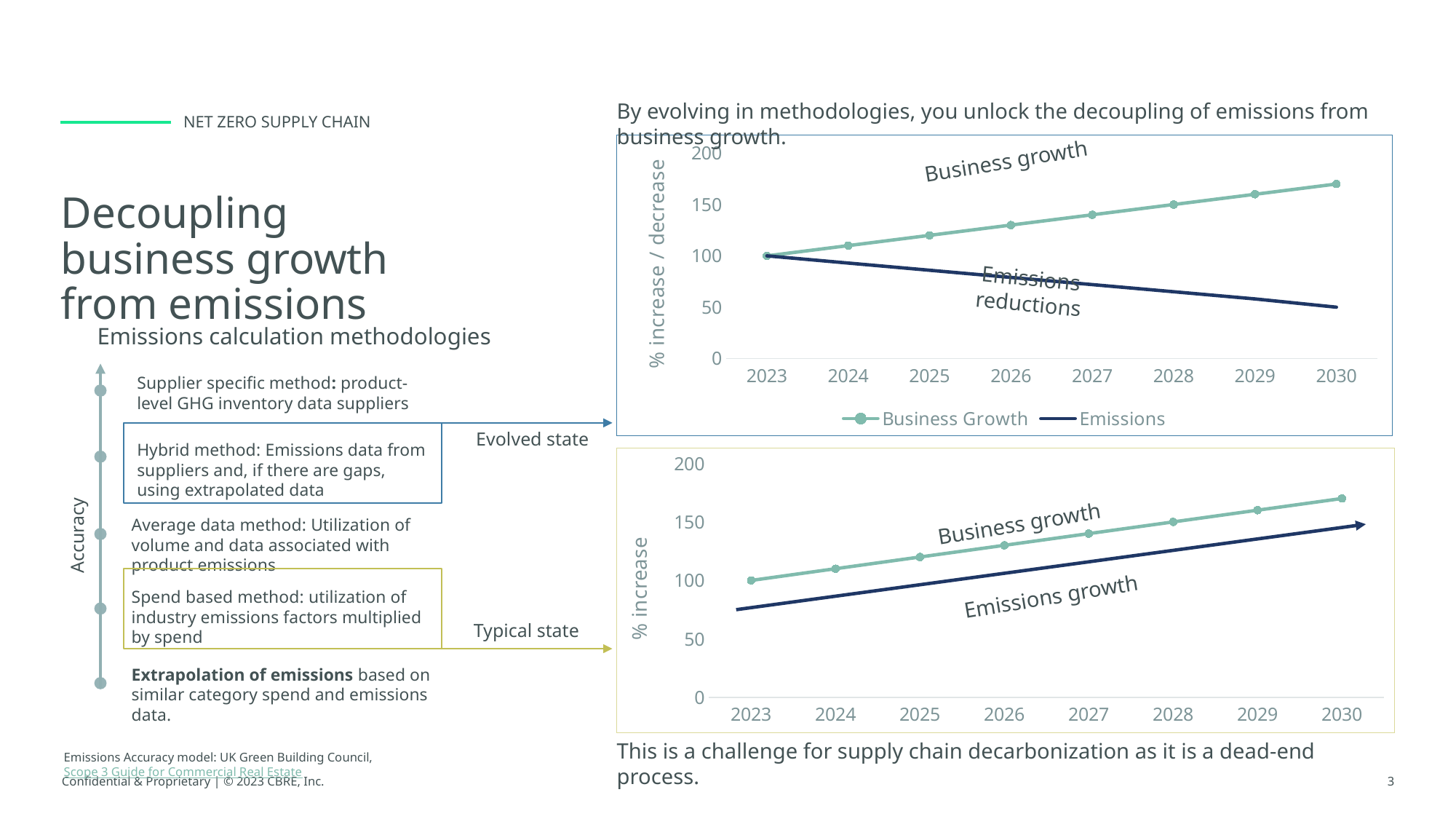
In the top chart, is the Business Growth value for 2030 greater or less than 150? greater How many years are shown on the x axis of the top chart? 8 In the top chart, which series is higher in 2030, Business Growth or Emissions? Business Growth In the top chart, what is the value of Business Growth in 2023? 100 What kind of chart is the top chart on the slide? line chart In the bottom chart, is the Emissions growth value for 2023 greater or less than 100? less In the top chart, do the Emissions values rise or fall from 2023 to 2030? fall In the top chart, do the Business Growth values rise or fall from 2023 to 2030? rise What are the two series named in the legend of the top chart? Business Growth and Emissions In the top chart, is the Emissions value for 2030 greater or less than 100? less How many series does the legend of the top chart list? 2 In the bottom chart, what is the value of Business growth in 2023? 100